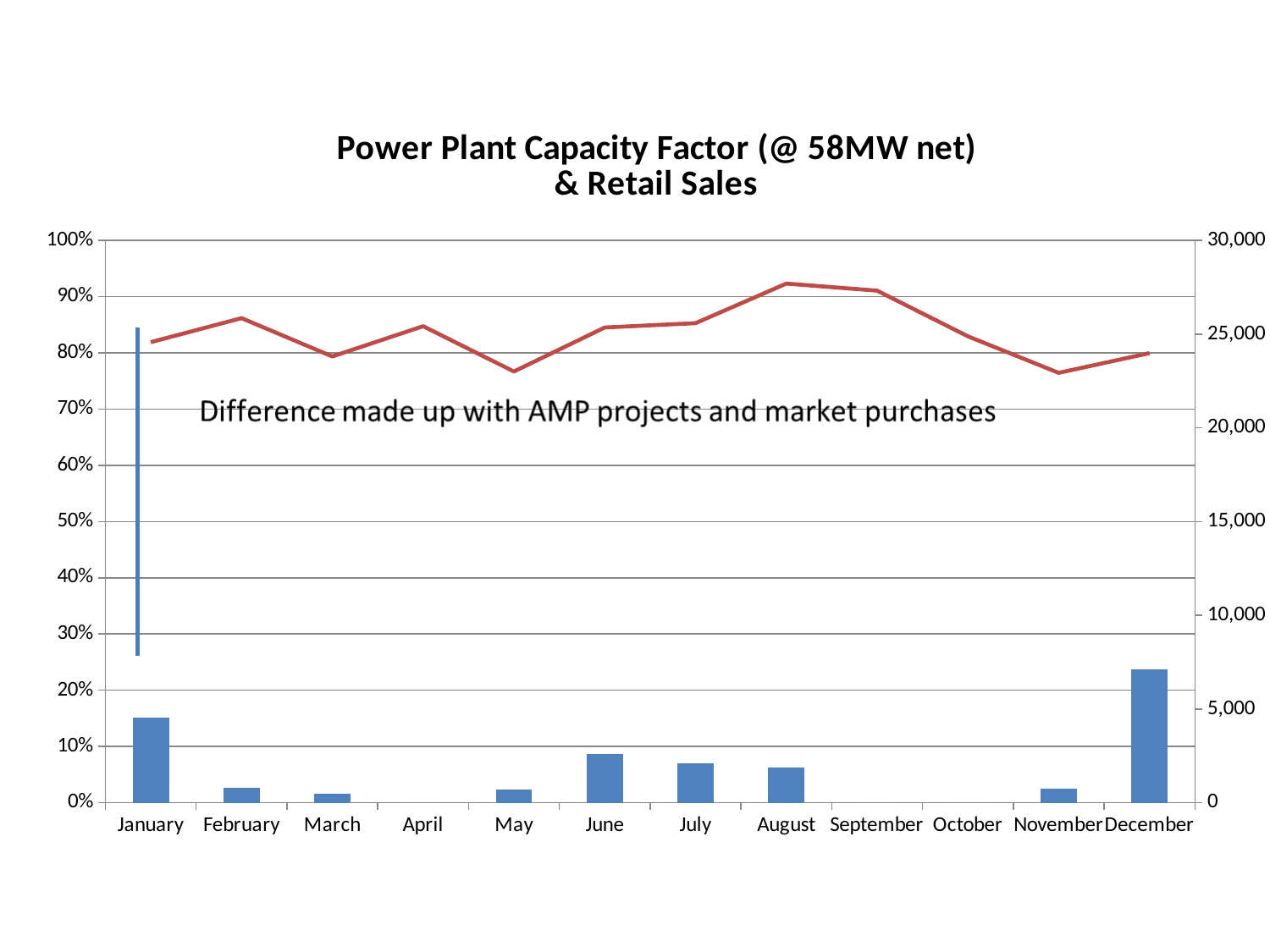
Is the red line value for May greater or less than 25,000 on the right axis? less What does the text annotation inside the chart say? Difference made up with AMP projects and market purchases Which has the taller bar, June or August? June Is the bar value for January greater or less than 20%? less Which month has the tallest bar? December What is the title of the chart? Power Plant Capacity Factor (@ 58MW net) & Retail Sales In which month does the red line reach its highest point? August How many months are shown along the x axis? 12 Is the bar value for December greater or less than 20%? greater What kind of chart is shown on the slide? A combination bar and line chart Does the red line rise or fall from August to November? fall